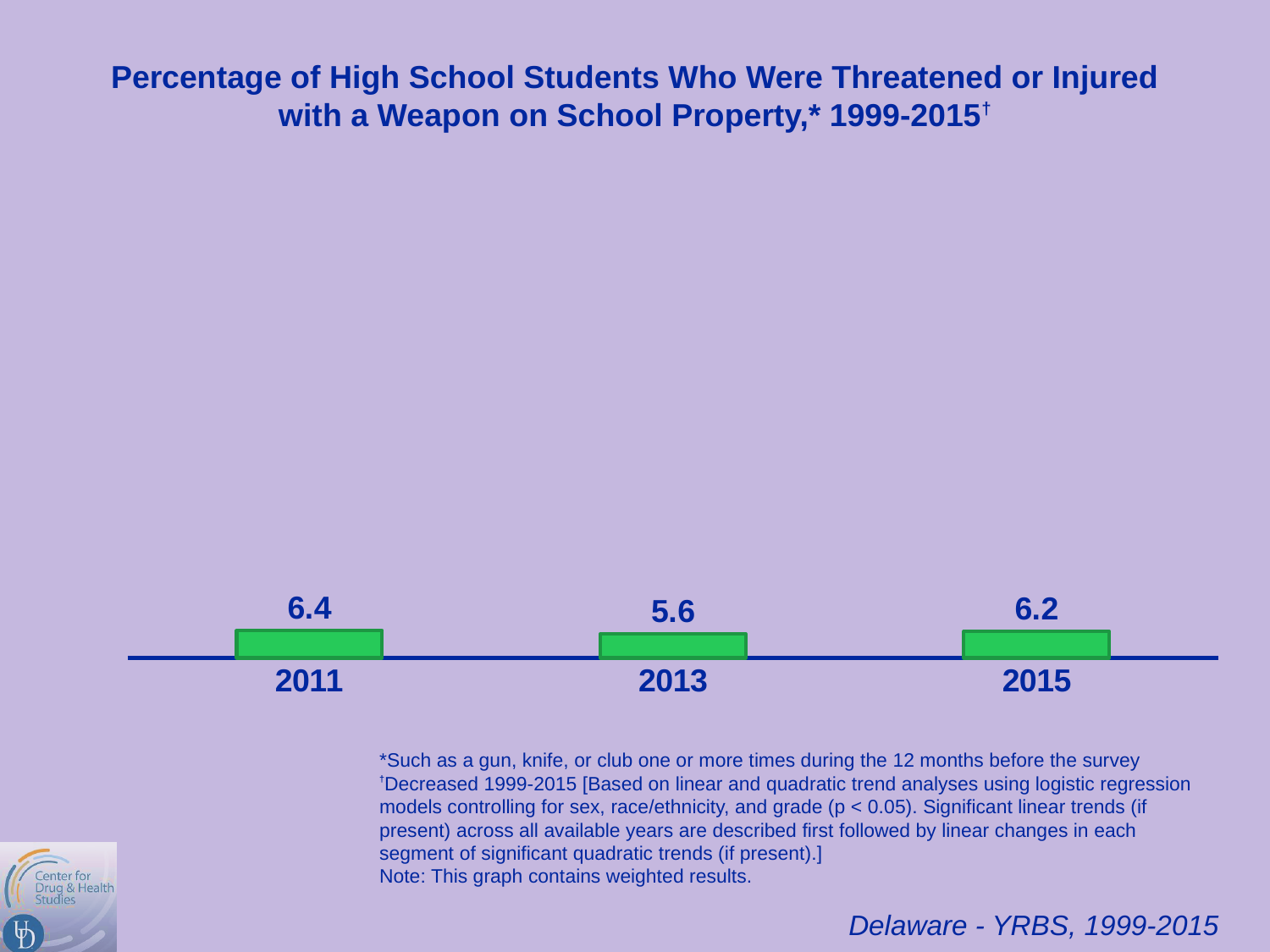
What is the difference between the values for 2011 and 2013? 0.8 Which year has the highest value? 2011 How many years are shown on the chart? 3 What kind of chart is shown on the slide? bar chart Which year has the lowest value? 2013 What is the difference between the values for 2015 and 2013? 0.6 What is the value for 2015? 6.2 What is the value for 2011? 6.4 Does the value rise or fall from 2011 to 2013? fall What is the value for 2013? 5.6 What colour are the bars in the chart? green Which is larger, the value for 2011 or the value for 2015? 2011